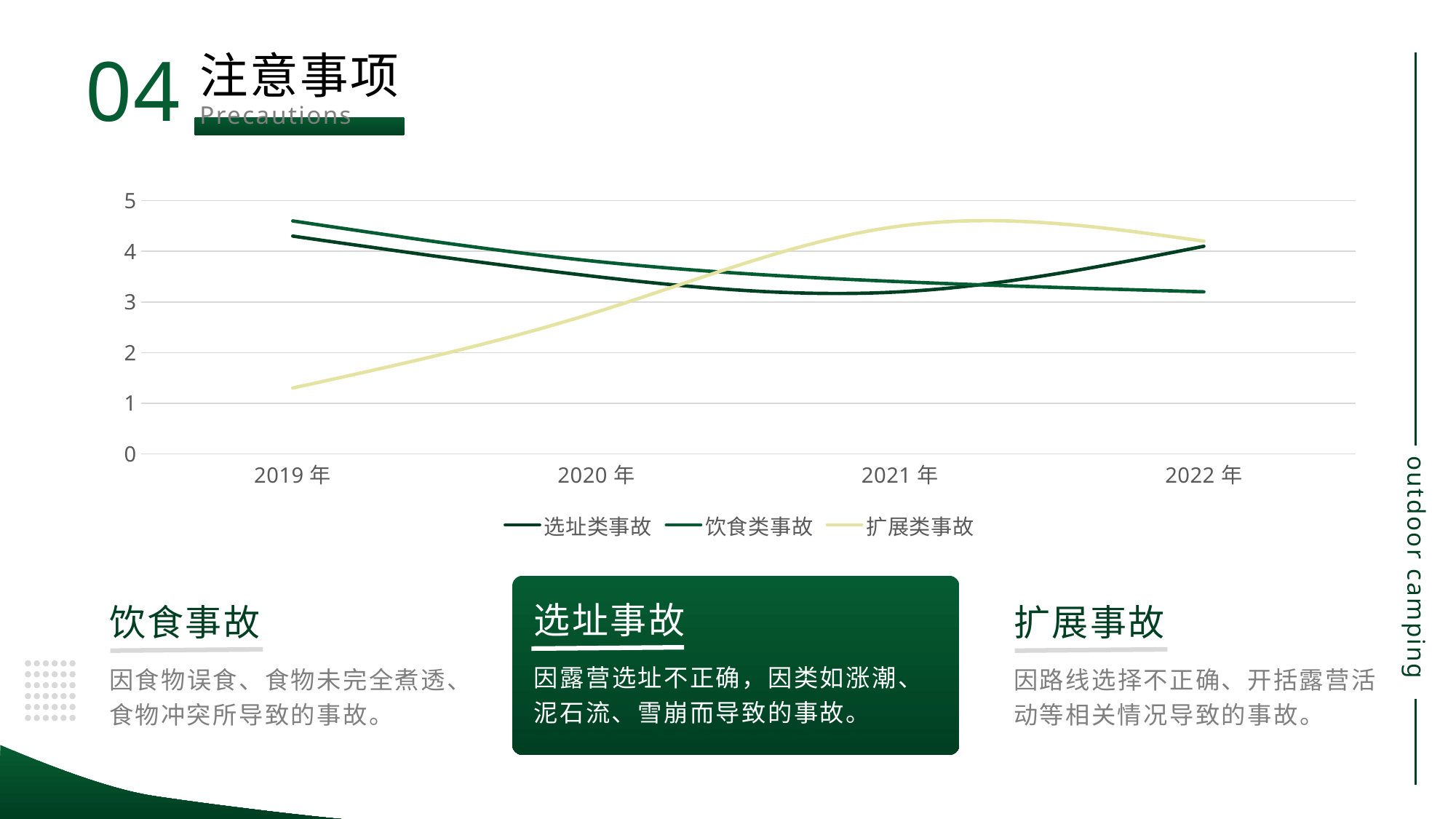
How many series does the chart legend list? 3 Which series has the highest value in 2019 年? 饮食类事故 How many years are shown on the x axis of the chart? 4 Is the value for 饮食类事故 in 2019 年 greater or less than 4? greater What kind of chart is shown on the slide? line chart Which series has the lowest value in 2022 年? 饮食类事故 In 2022 年, which is larger: 扩展类事故 or 饮食类事故? 扩展类事故 Does the 饮食类事故 line rise or fall from 2019 年 to 2022 年? fall Which series has the lowest value in 2019 年? 扩展类事故 Is the value for 扩展类事故 in 2019 年 greater or less than 2? less Which series has the highest value in 2021 年? 扩展类事故 Is the value for 选址类事故 in 2021 年 greater or less than 4? less